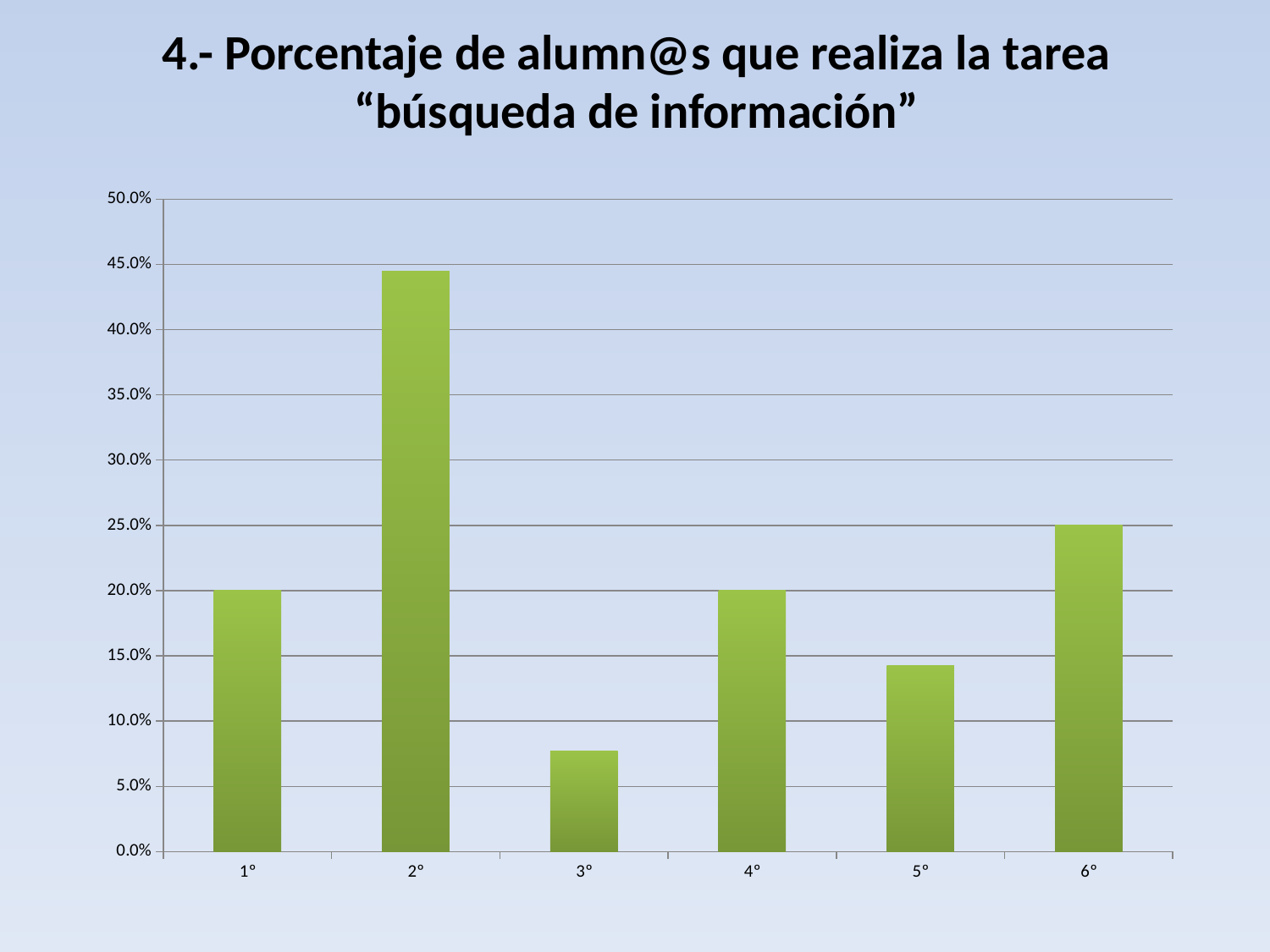
What kind of chart is shown on the slide? bar chart Which is larger, the value for 2° or the value for 4°? 2° Is the value for 5° greater or less than 15.0%? less What is the value for 1° in the chart? 20.0% What is the value for 6° in the chart? 25.0% Is the value for 2° greater or less than 40.0%? greater What is the title of the chart on the slide? 4.- Porcentaje de alumn@s que realiza la tarea "búsqueda de información" Which category has the highest value in the chart? 2° Which is larger, the value for 5° or the value for 6°? 6° Which category has the lowest value in the chart? 3° Is the value for 3° greater or less than 10.0%? less How many categories are shown on the x axis of the chart? 6